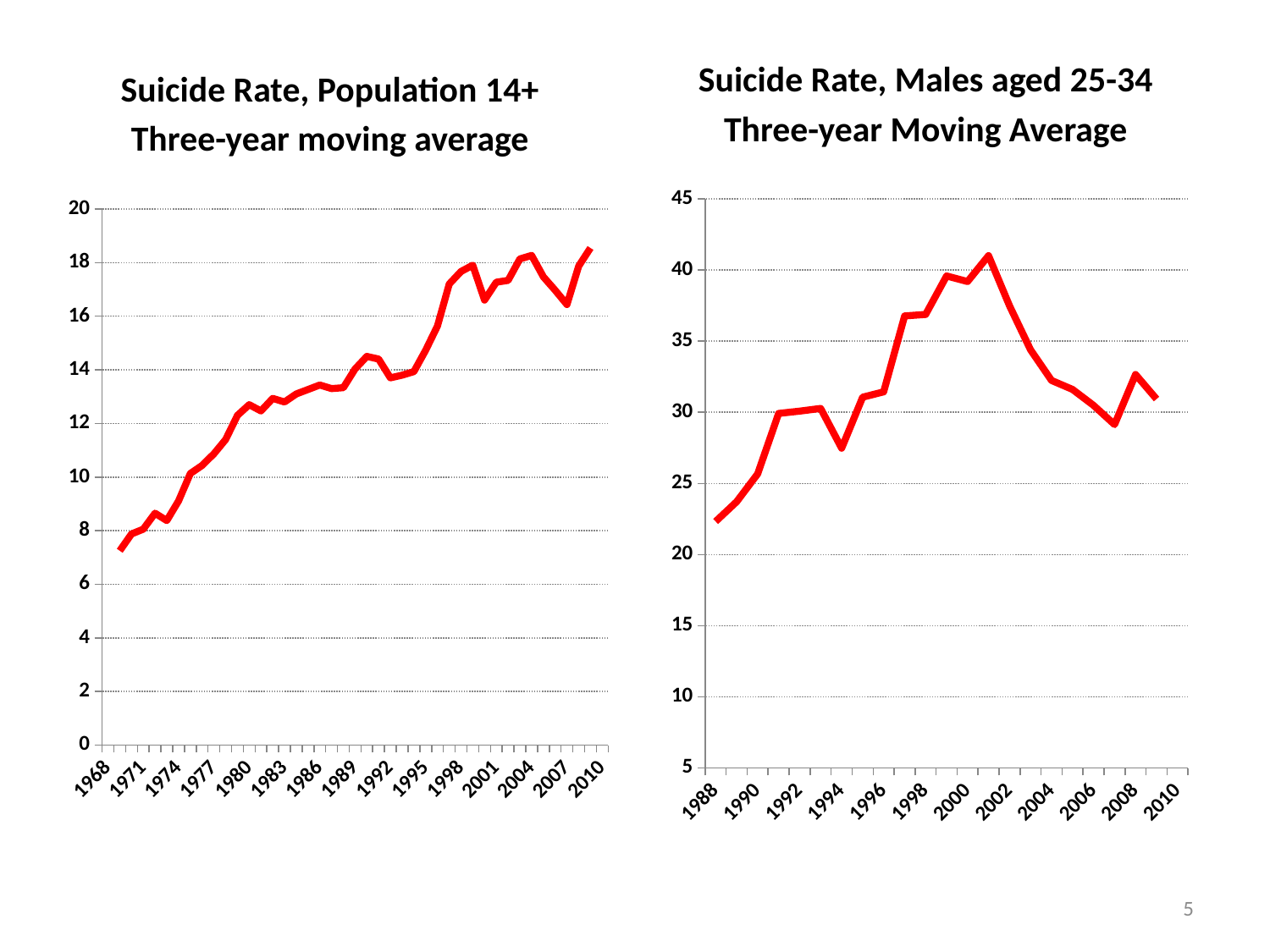
What kind of chart is the right chart, 'Suicide Rate, Males aged 25-34'? line chart In the left chart, 'Suicide Rate, Population 14+', which year has the lowest value? 1969 In the right chart, 'Suicide Rate, Males aged 25-34', do the values rise or fall from 2002 to 2008? fall In the right chart, 'Suicide Rate, Males aged 25-34', which year has the lowest value? 1988 In the left chart, 'Suicide Rate, Population 14+', is the value for 1998 greater or less than 16? greater In the right chart, 'Suicide Rate, Males aged 25-34', is the highest value on the line greater or less than 40? greater In the left chart, 'Suicide Rate, Population 14+', do the values generally rise or fall from 1968 to 2010? rise In the right chart, 'Suicide Rate, Males aged 25-34', is the value for 1994 greater or less than 30? less What kind of chart is the left chart, 'Suicide Rate, Population 14+'? line chart